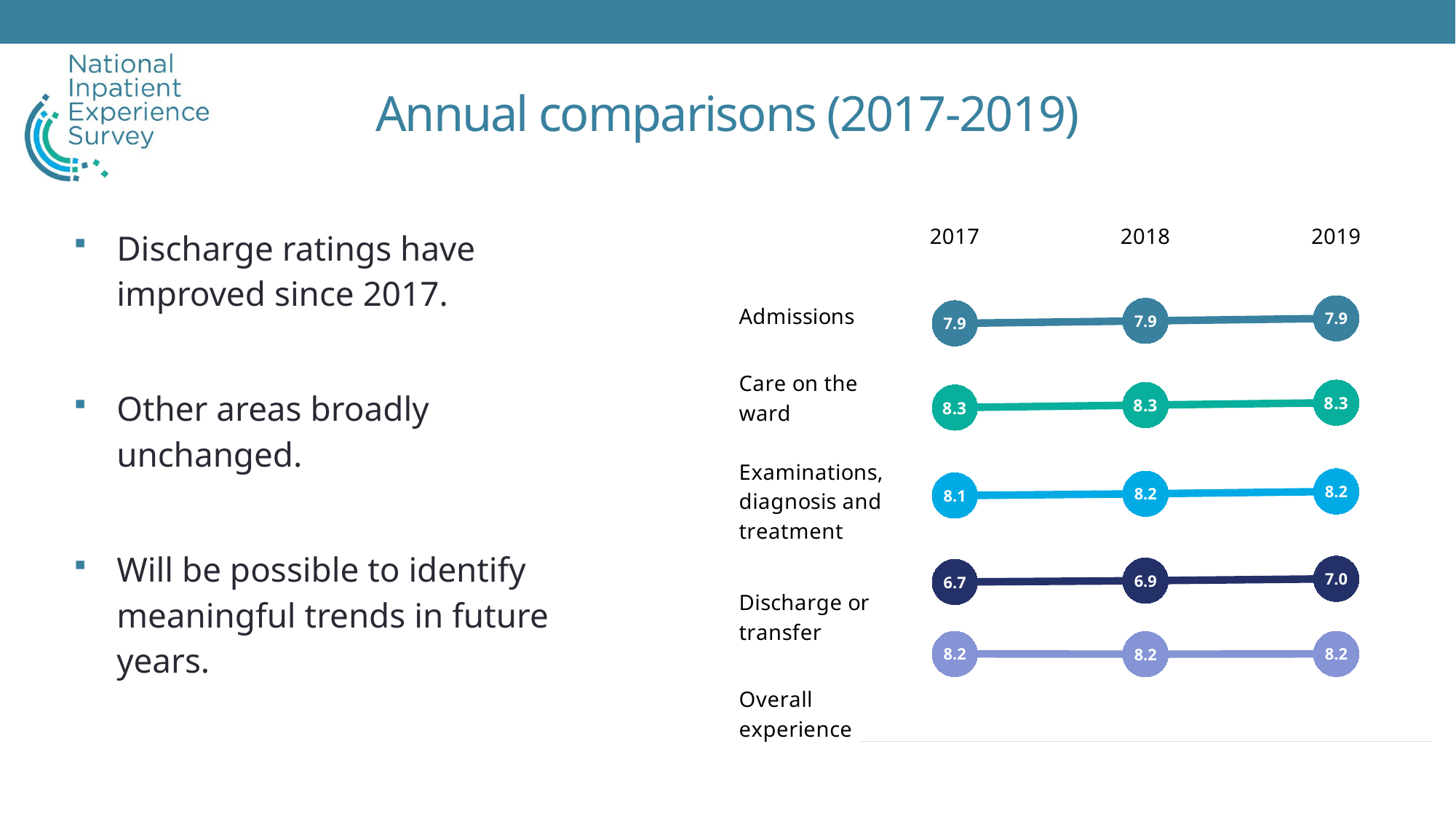
Which area had the lowest rating in 2017? Discharge or transfer By how much did the Discharge or transfer rating increase from 2017 to 2019? 0.3 What type of chart is shown on the slide? line chart Which area had the highest rating in 2019? Care on the ward What was the Admissions rating in 2019? 7.9 Which was higher in 2018, the Admissions rating or the Overall experience rating? Overall experience Did the Discharge or transfer rating rise or fall from 2017 to 2019? rise What was the Care on the ward rating in 2018? 8.3 What was the Examinations, diagnosis and treatment rating in 2017? 8.1 What was the Discharge or transfer rating in 2017? 6.7 How many years are compared in the chart? 3 What was the Discharge or transfer rating in 2019? 7.0